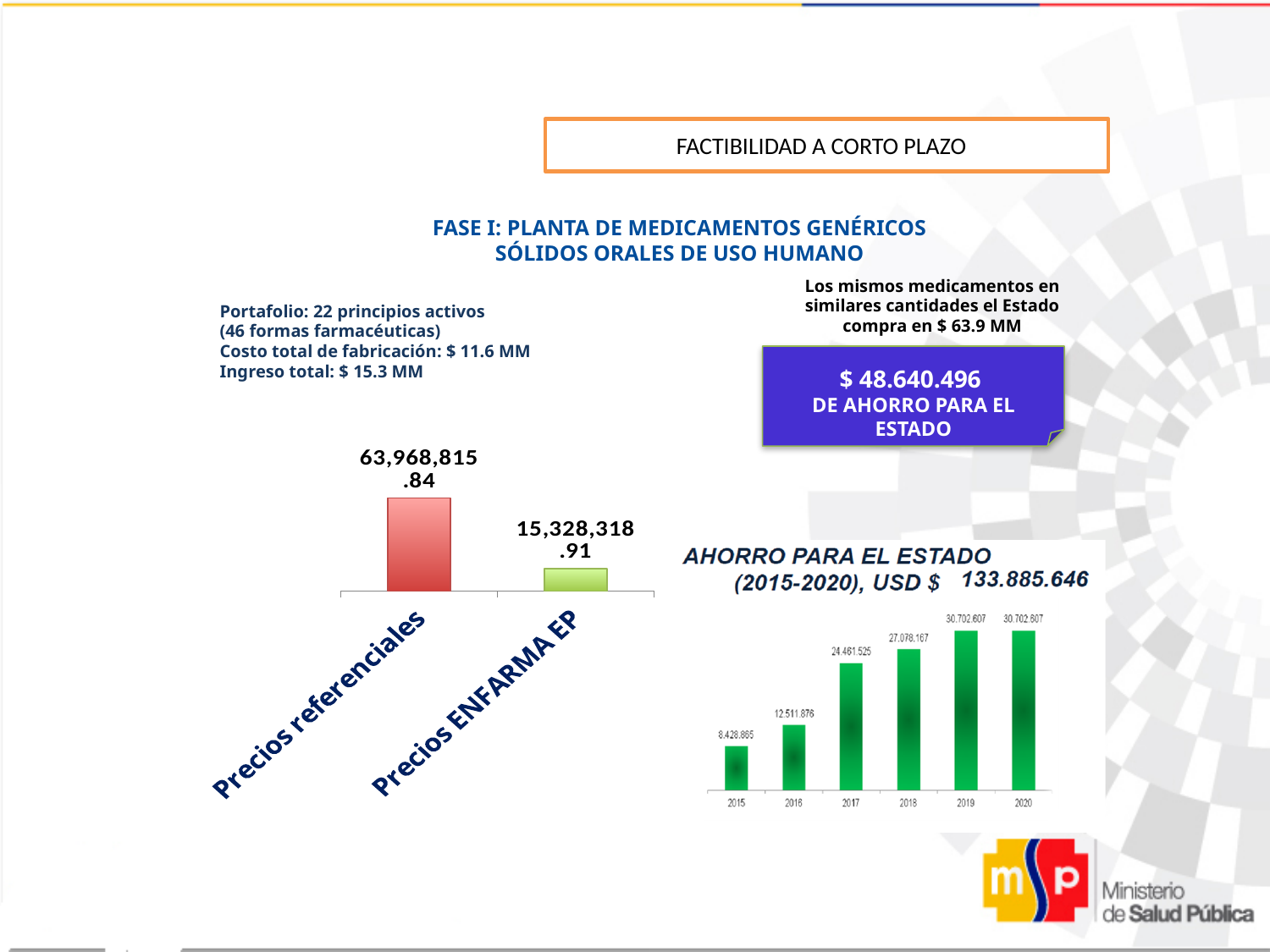
In the left chart, which category has the higher value, Precios referenciales or Precios ENFARMA EP? Precios referenciales In the left chart, what is the value for Precios ENFARMA EP? 15,328,318.91 In the chart titled AHORRO PARA EL ESTADO (2015-2020), USD $, what is the value for 2015? 8.428.865 In the left chart, what is the value for Precios referenciales? 63,968,815.84 In the chart titled AHORRO PARA EL ESTADO (2015-2020), USD $, how many years are plotted? 6 In the chart titled AHORRO PARA EL ESTADO (2015-2020), USD $, what is the value for 2017? 24.461.525 In the chart titled AHORRO PARA EL ESTADO (2015-2020), USD $, do the values generally rise or fall from 2015 to 2020? Rise In the chart titled AHORRO PARA EL ESTADO (2015-2020), USD $, which year has the lowest value? 2015 In the chart titled AHORRO PARA EL ESTADO (2015-2020), USD $, what is the difference between the values for 2019 and 2018? 3.624.440 What total figure is printed next to the title of the chart AHORRO PARA EL ESTADO (2015-2020), USD $? 133.885.646 What kind of chart is the left chart comparing Precios referenciales and Precios ENFARMA EP? Bar chart How many bars are plotted in the left chart? 2